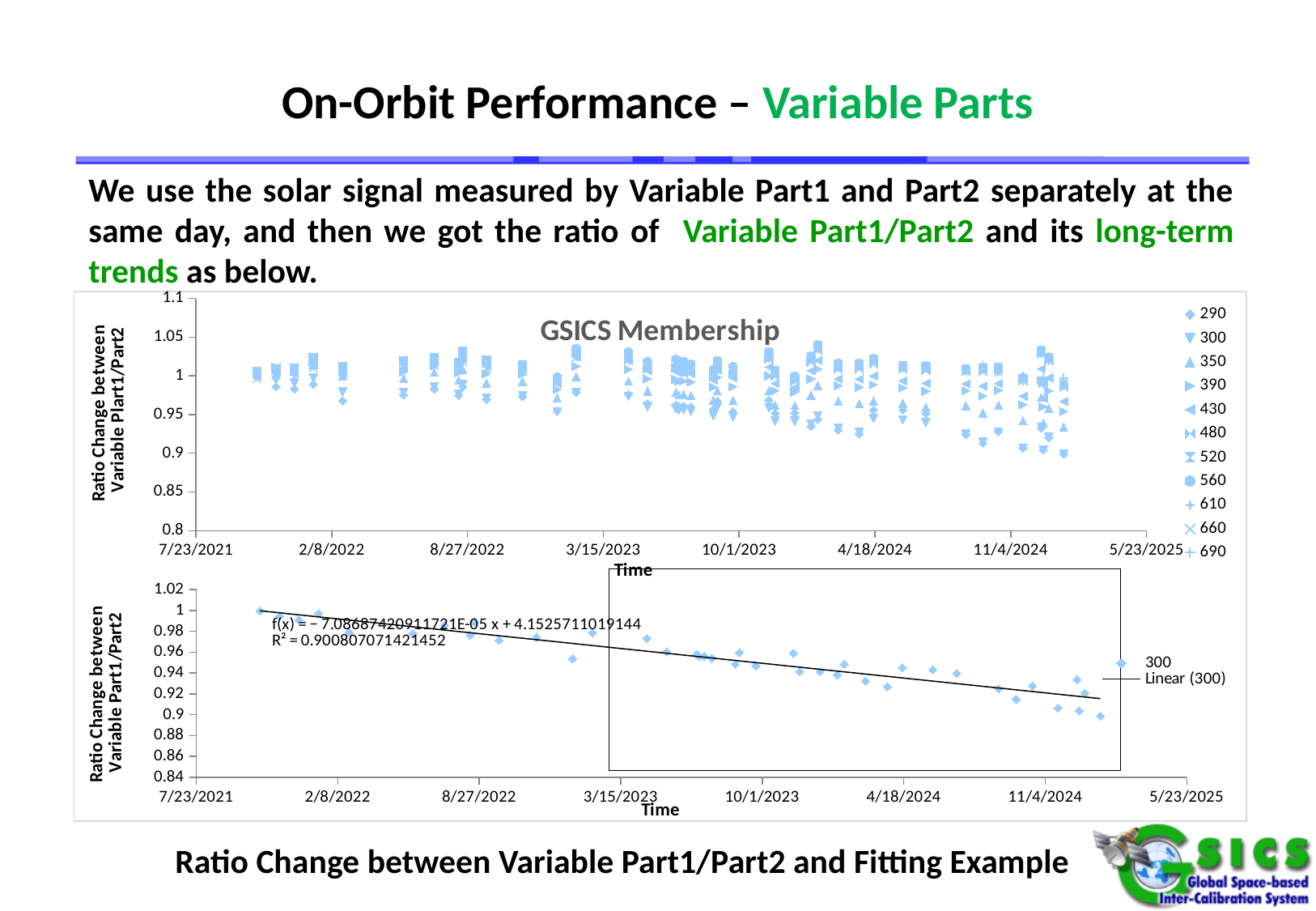
In the bottom chart, is the value of the first plotted point (near the start of the series) greater or less than 0.98? greater In the bottom chart, what is the R² value printed for the linear fit? R² = 0.900807071421452 How many entries does the legend of the bottom chart list? 2 How many series does the legend of the top chart list? 11 In the top chart, are any plotted points below 0.85 on the y axis? no In the bottom chart, is the value of the last plotted point (near 2025) greater or less than 0.94? less What kind of chart is the bottom chart on the slide? scatter chart In the bottom chart, which series does the straight line represent according to the legend? Linear (300) In the bottom chart, do the plotted ratio values rise or fall over time along the x axis? fall What is the first series listed in the legend of the top chart? 290 What is the label of the x axis on both charts? Time